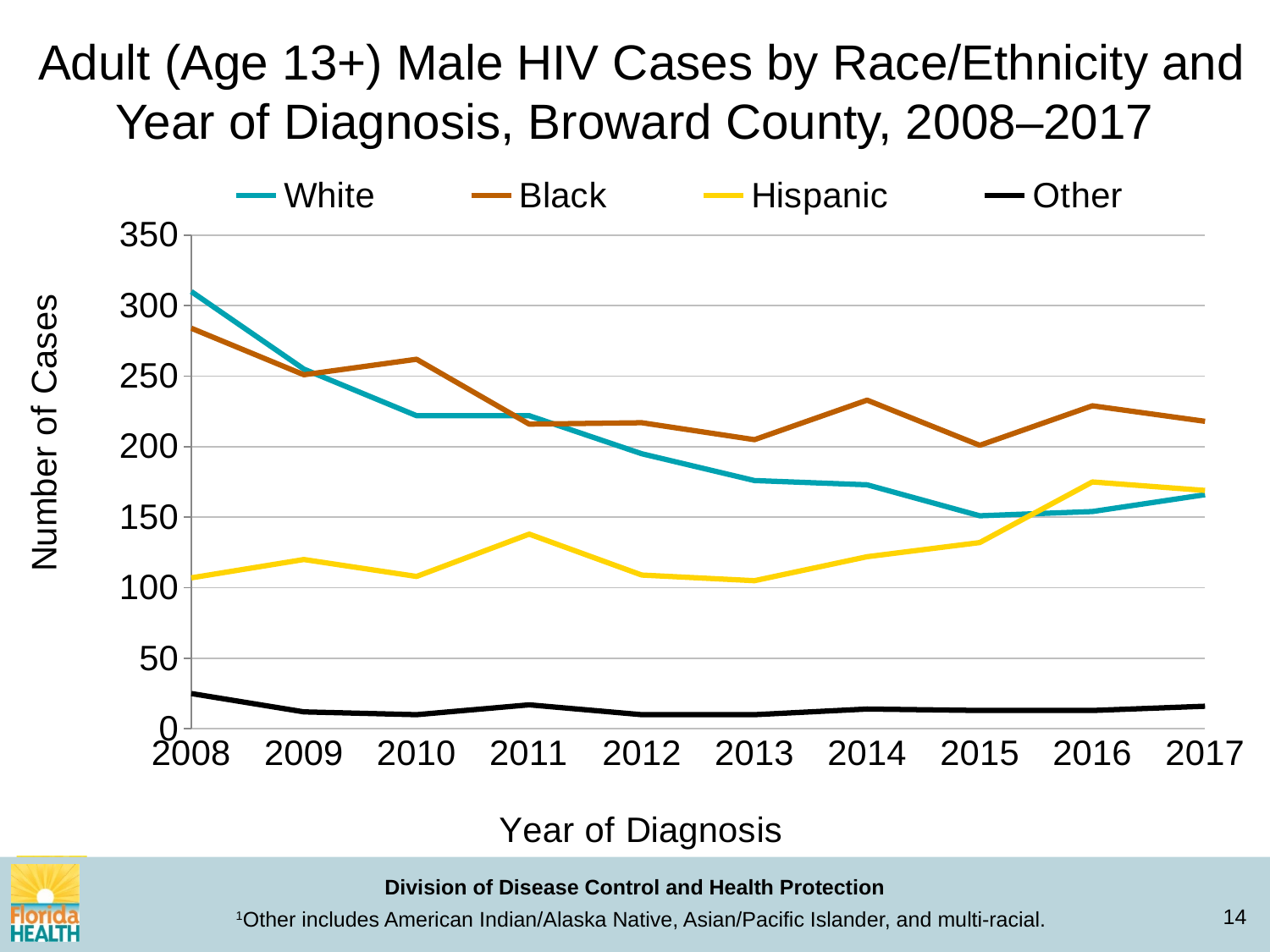
In 2017, which is larger, the value for Black or the value for White? Black Is the value for Hispanic in 2013 greater or less than 150? less Is the value for Black in 2008 greater or less than 250? greater Is the value for Other in 2008 greater or less than 50? less How many years of diagnosis are plotted along the x axis? 10 In 2008, which is larger, the value for White or the value for Black? White Does the White series rise or fall overall from 2008 to 2017? fall What kind of chart is shown on the slide? line chart Which race/ethnicity has the highest number of cases in 2014? Black How many series does the legend list? 4 Which race/ethnicity has the lowest number of cases in every year shown? Other